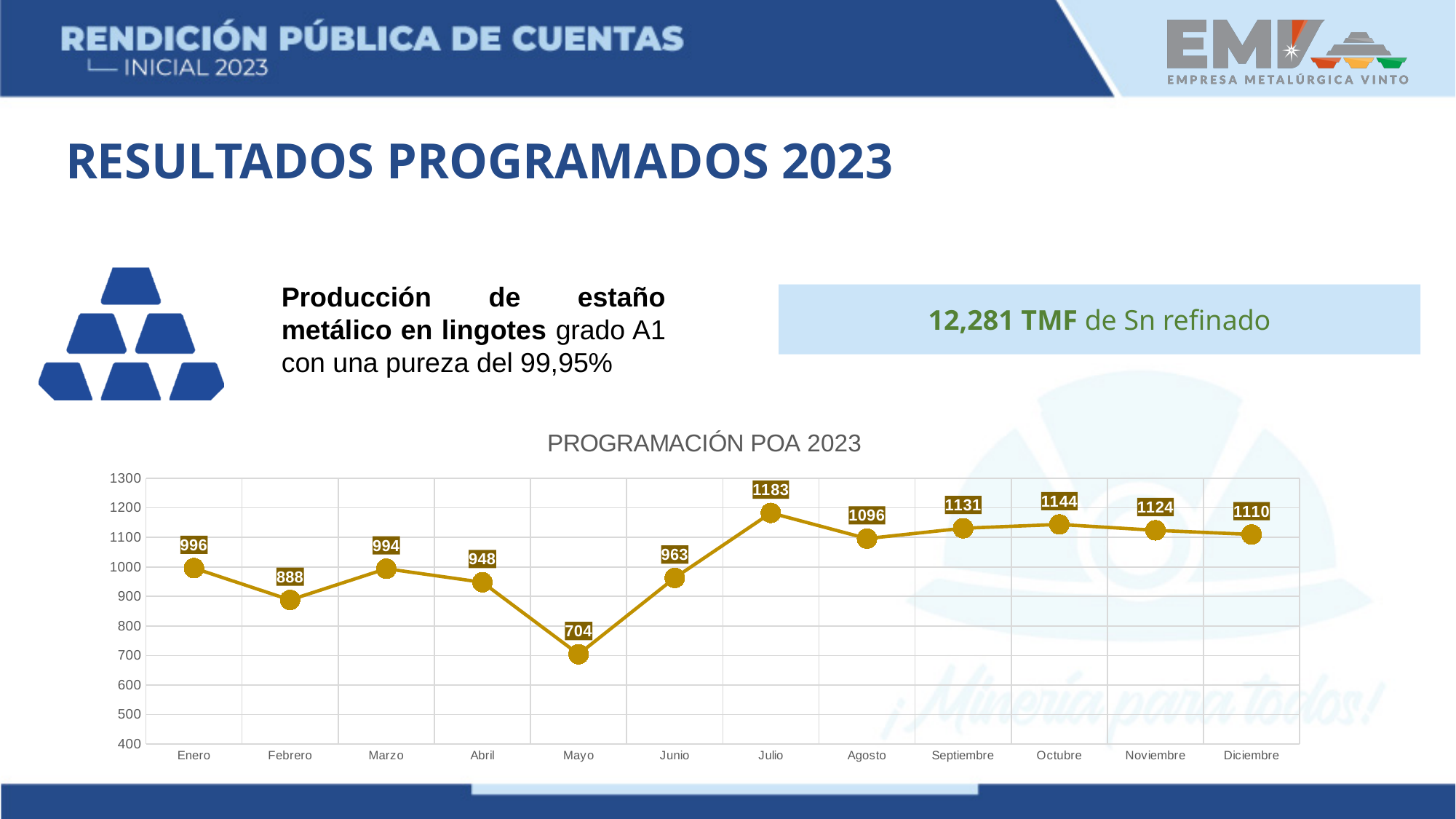
Which is larger, the value for Enero or the value for Febrero? Enero What is the value for Octubre? 1144 Is the value for Abril greater or less than 1000? less Do the values rise or fall from Mayo to Julio? rise What kind of chart is shown? line chart How many months are plotted on the chart? 12 What is the title of the chart? PROGRAMACIÓN POA 2023 What is the difference between the values for Julio and Mayo? 479 What is the value for Julio? 1183 Which month has the lowest value? Mayo What is the value for Mayo? 704 Which month has the highest value? Julio